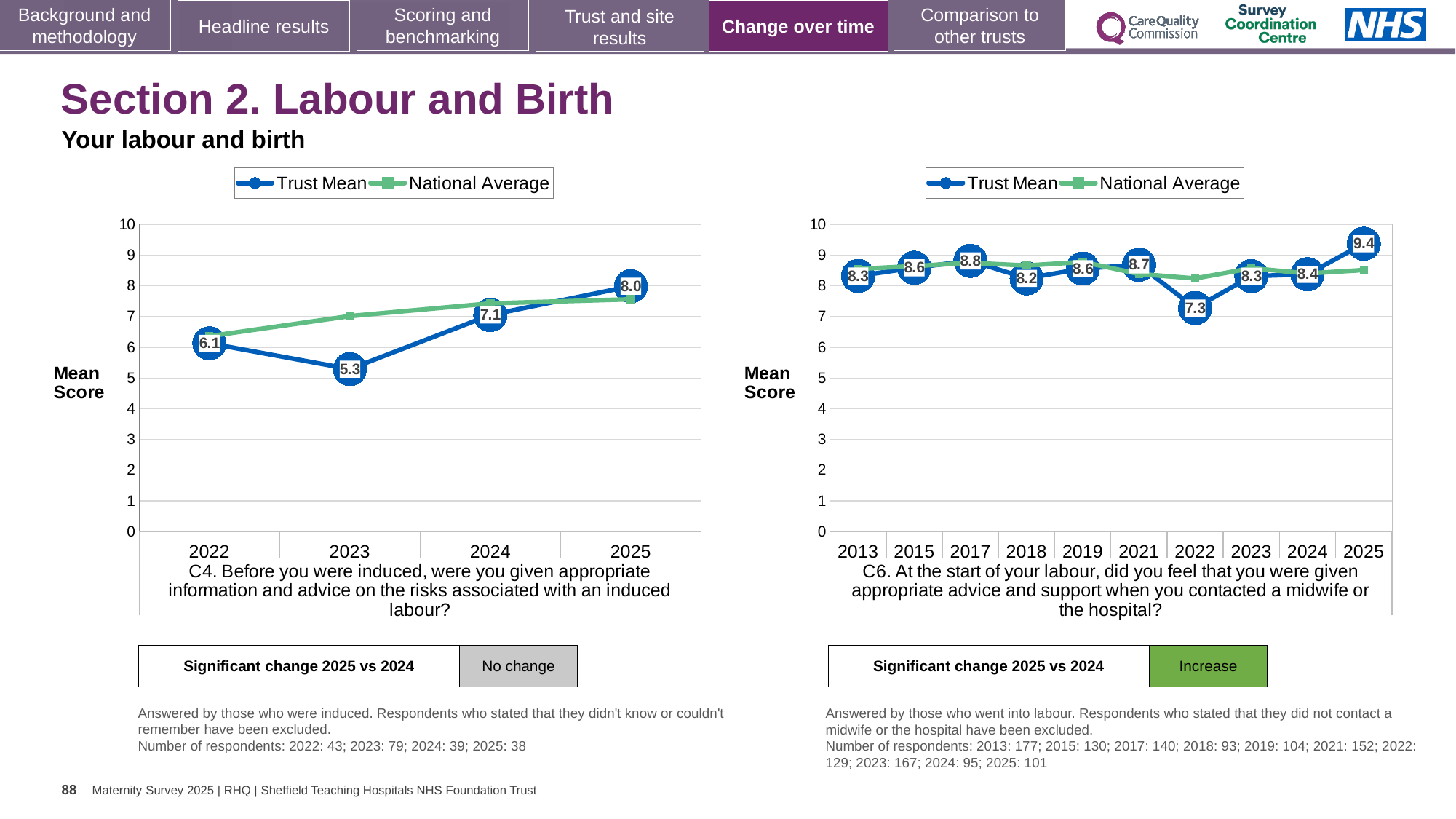
In the left chart (C4), which year has the lowest Trust Mean score? 2023 In the left chart (C4), what is the Trust Mean score for 2023? 5.3 In the right chart (C6), which year has the highest Trust Mean score? 2025 In the right chart (C6), how many years are shown on the x axis? 10 In the right chart (C6), what is the Trust Mean score for 2022? 7.3 In the right chart (C6), which is larger, the Trust Mean score for 2017 or for 2018? 2017 What kind of chart is the left chart (C4)? Line chart In the left chart (C4), what is the difference between the Trust Mean scores for 2025 and 2022? 1.9 In the left chart (C4), what is the Trust Mean score for 2025? 8.0 In the left chart (C4), is the National Average for 2023 greater or less than 6? greater In the left chart (C4), how many years are shown on the x axis? 4 How many series does the legend of the right chart (C6) list? 2